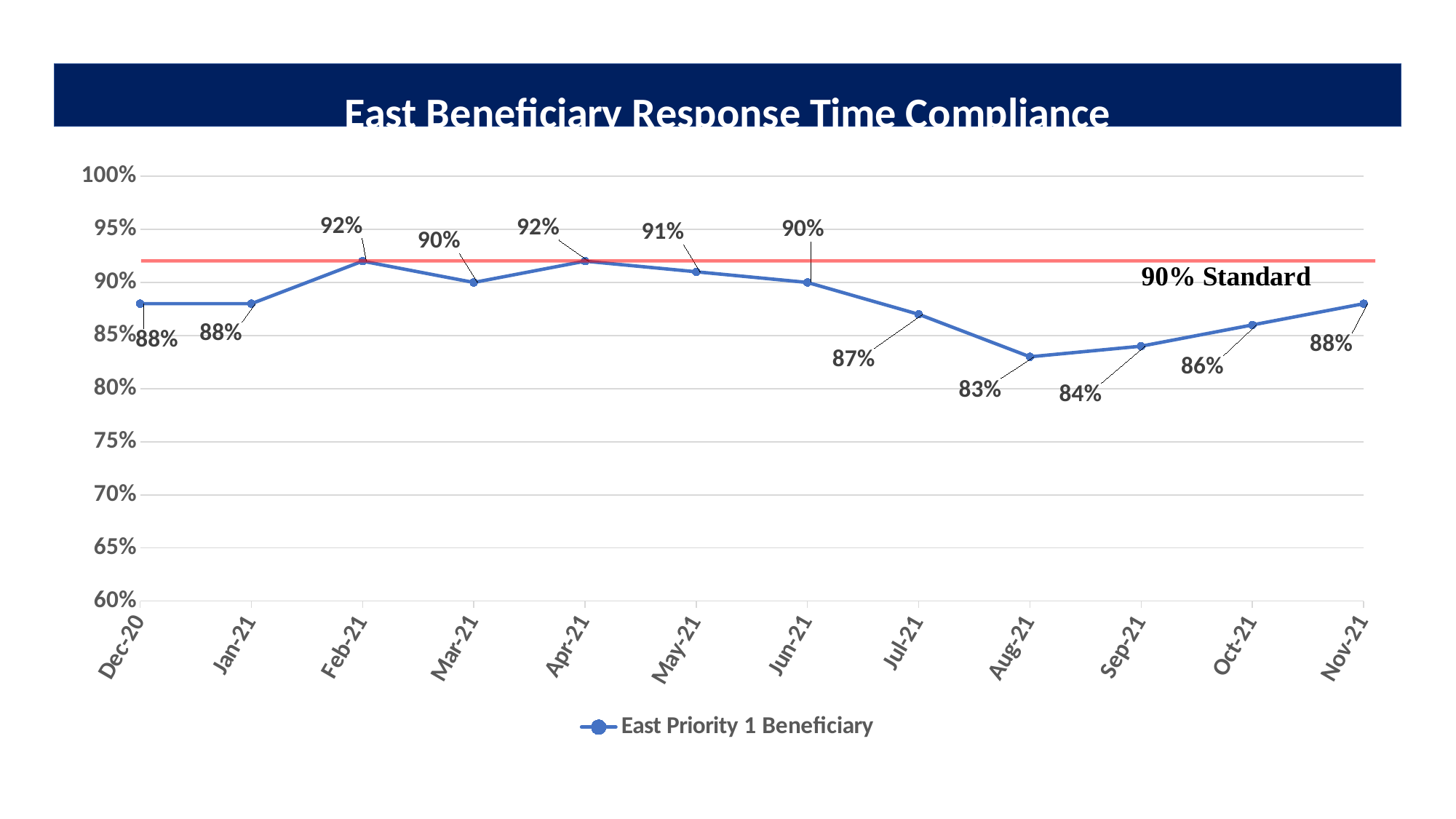
What is the difference between the values for Feb-21 and Aug-21? 9% What is the value for Nov-21? 88% What is the highest value plotted on the chart? 92% What is the value for May-21? 91% How many series does the legend list? 1 Is the value for Jul-21 greater or less than 90%? less Which is larger, the value for Mar-21 or the value for Sep-21? Mar-21 What is the label on the red horizontal line? 90% Standard Which month has the lowest value? Aug-21 How many months are plotted on the x axis? 12 What kind of chart is shown on the slide? line chart What is the value for Aug-21? 83%